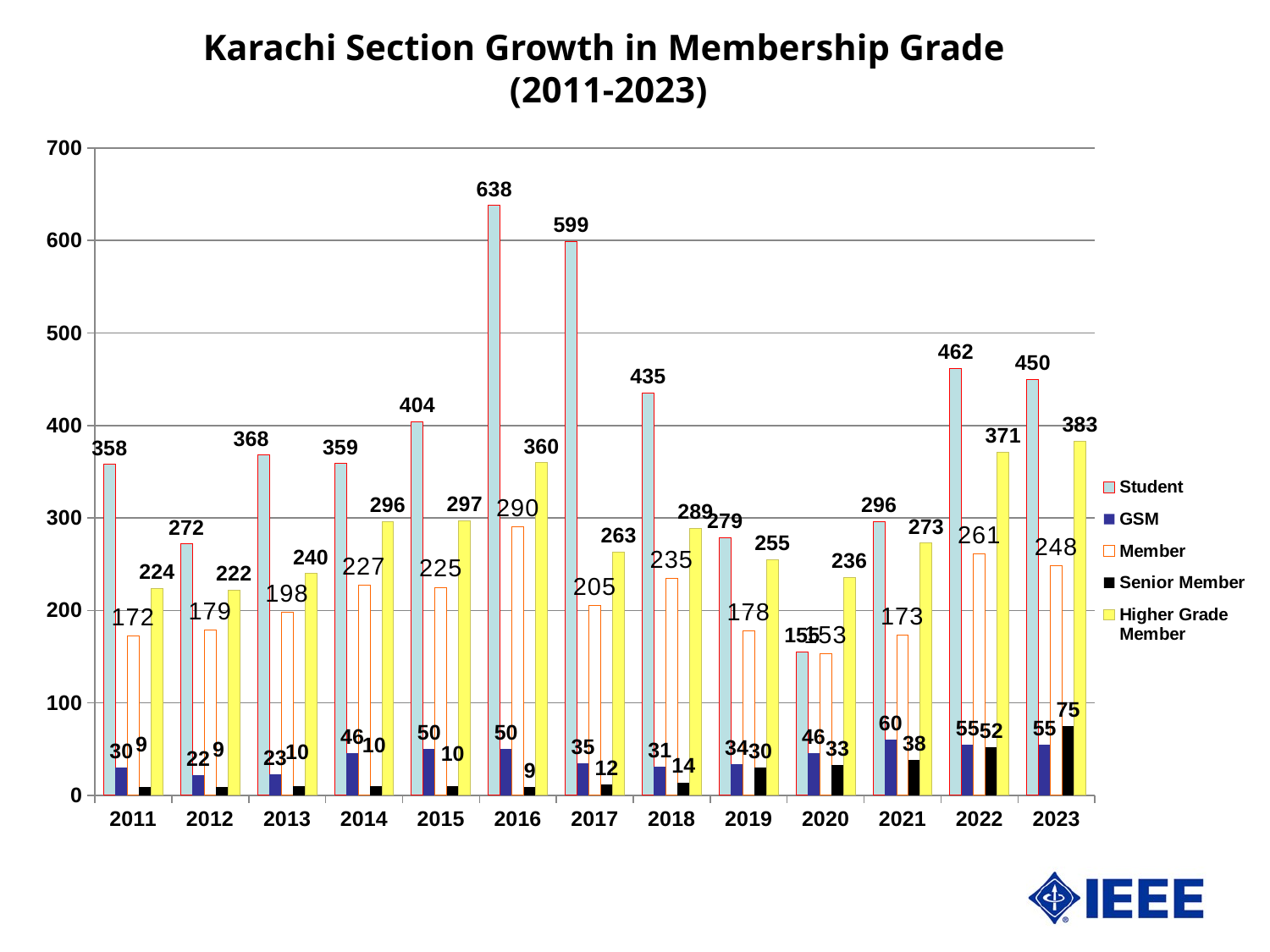
What is the Student value for 2016? 638 Is the Student value for 2022 greater or less than 400? greater What is the Senior Member value for 2023? 75 Do the Senior Member values rise or fall from 2019 to 2023? Rise In which year is the Student value highest? 2016 How many series does the legend list? 5 In 2022, which is larger: the Member value or the Higher Grade Member value? Higher Grade Member What kind of chart is shown on the slide? Bar chart What is the difference between the Student values for 2016 and 2017? 39 How many years are shown on the x axis? 13 What is the Higher Grade Member value for 2023? 383 In which year is the Student value lowest? 2020